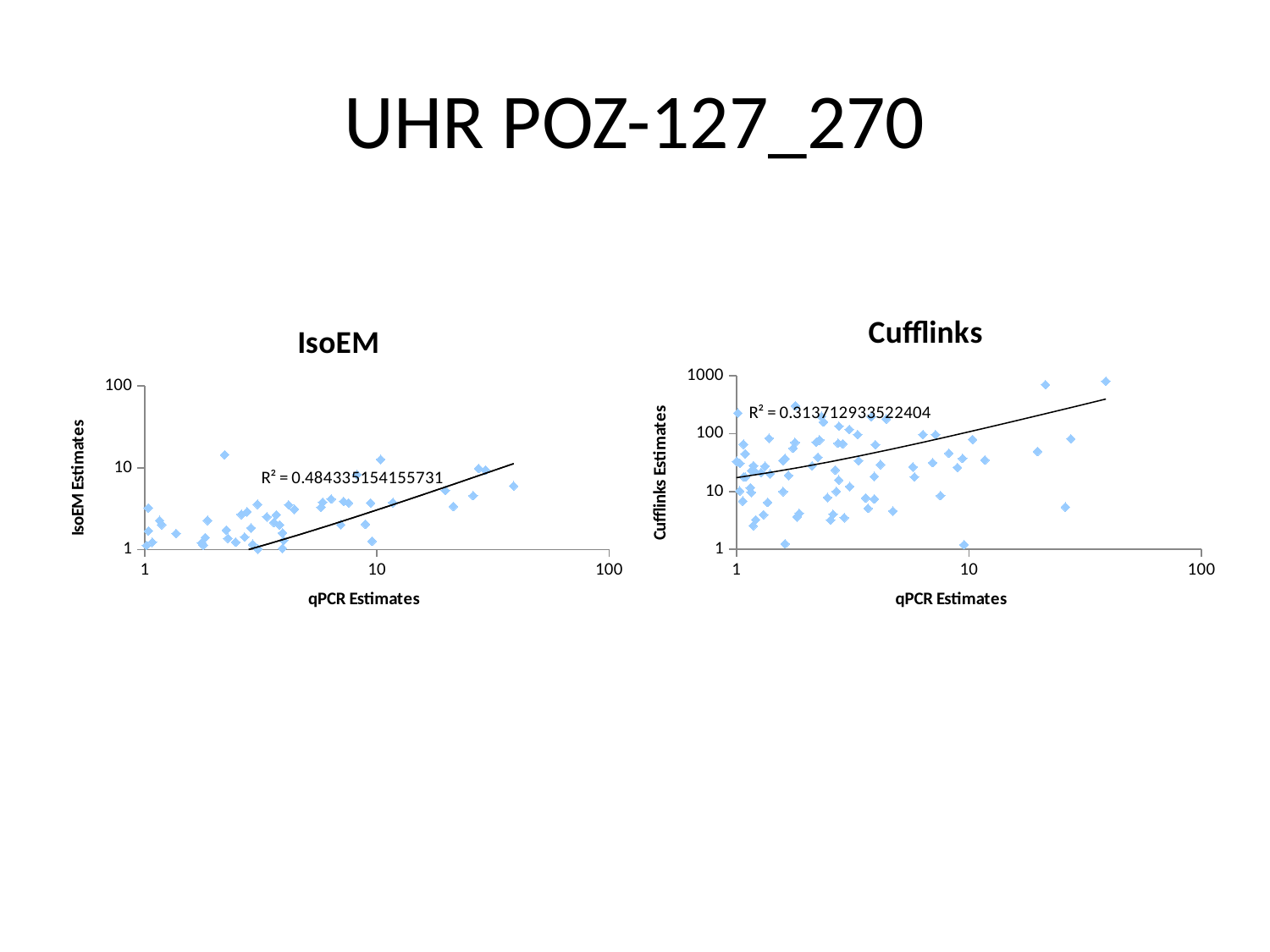
On the Cufflinks chart, does the fitted trend line rise or fall as qPCR Estimates increase? rise On the Cufflinks chart, is the highest plotted Cufflinks estimate greater or less than 100? greater What is the x-axis title on the Cufflinks chart? qPCR Estimates On the IsoEM chart, is the highest plotted IsoEM estimate greater or less than 100? less What kind of chart is the IsoEM chart? scatter chart What R² value is printed on the IsoEM chart? R² = 0.484335154155731 What is the y-axis title on the IsoEM chart? IsoEM Estimates How many charts are shown on the slide? 2 Which chart shows the higher R² value, IsoEM or Cufflinks? IsoEM What is the difference between the R² value on the IsoEM chart and the R² value on the Cufflinks chart? 0.170622220633327 On the IsoEM chart, does the fitted trend line rise or fall as qPCR Estimates increase? rise What R² value is printed on the Cufflinks chart? R² = 0.313712933522404